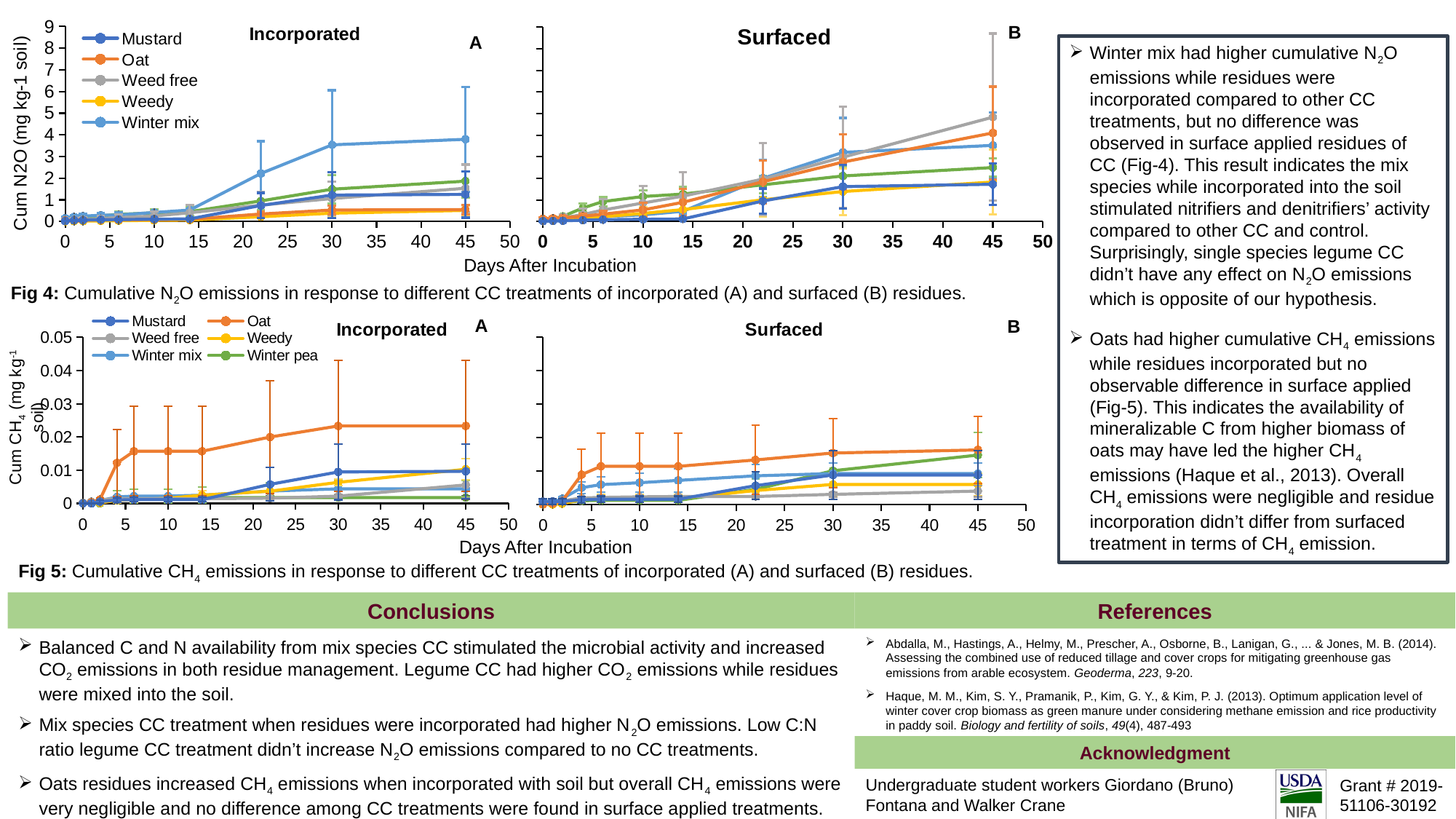
How many series does the legend of the Fig 5 Incorporated (A) chart list? 6 In the Fig 4 Incorporated (A) chart, is the Winter mix value at day 45 greater or less than 3? greater In the Fig 4 Incorporated (A) chart, does the Winter mix line rise or fall from day 0 to day 45? rise In the Fig 4 Incorporated (A) chart, which treatment has the highest cumulative N2O at day 45? Winter mix In the Fig 5 Incorporated (A) chart, which is larger at day 45, Oat or Mustard? Oat In the Fig 5 Incorporated (A) chart, which treatment has the highest cumulative CH4 at day 45? Oat In the Fig 4 Surfaced (B) chart, is the Weed free value at day 45 greater or less than 4? greater In the Fig 4 Incorporated (A) chart, is the Oat value at day 45 greater or less than 1? less How many series does the legend of the Fig 4 Incorporated (A) chart list? 5 In the Fig 4 Surfaced (B) chart, which treatment has the highest cumulative N2O at day 45? Weed free What kind of chart is the Fig 4 Incorporated (A) chart? line chart